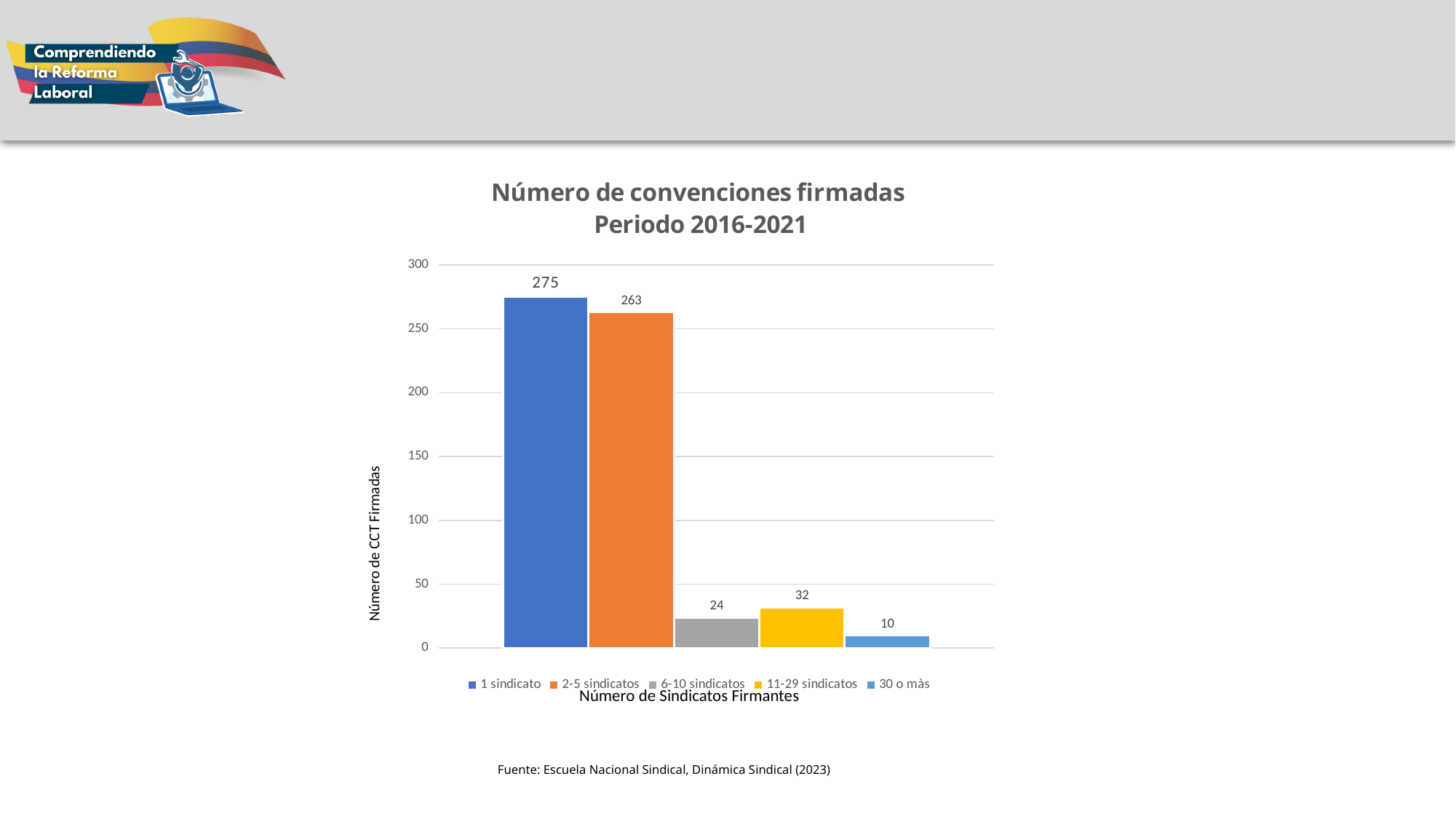
What is the value shown for '2-5 sindicatos'? 263 Which category has the highest number of conventions signed? 1 sindicato What is the value shown for '6-10 sindicatos'? 24 How many categories are shown in the chart? 5 What is the title of the chart? Número de convenciones firmadas Periodo 2016-2021 What is the number of conventions signed for '1 sindicato'? 275 Is the value for '2-5 sindicatos' greater or less than 250? greater Which is larger, the value for '6-10 sindicatos' or '11-29 sindicatos'? 11-29 sindicatos What is the value shown for '30 o màs'? 10 What is the difference between the values for '1 sindicato' and '2-5 sindicatos'? 12 Which category has the lowest number of conventions signed? 30 o màs What type of chart is shown on the slide? Bar chart